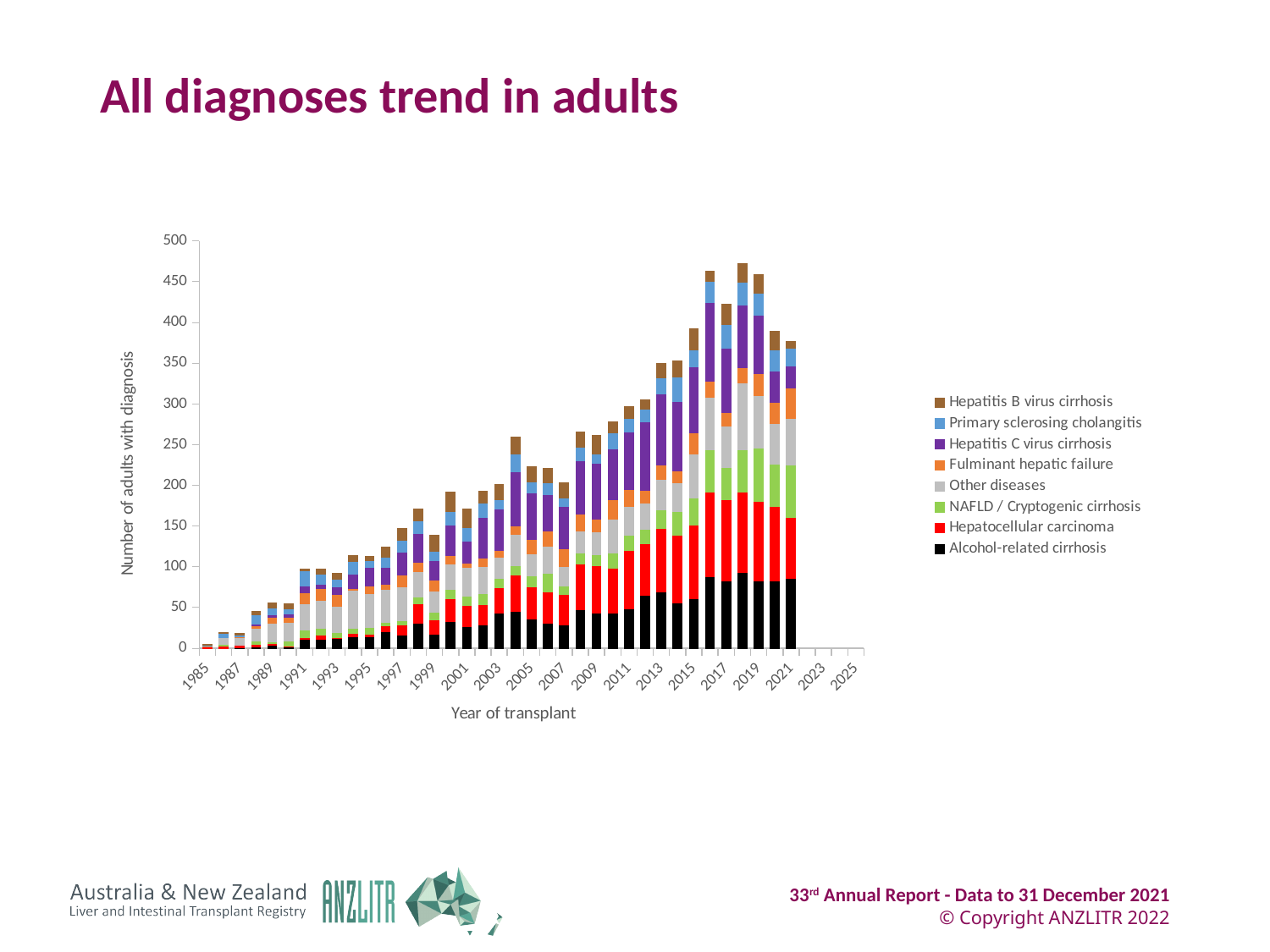
What kind of chart is shown on the slide? Stacked bar chart Is the total value for 1985 greater or less than 50? less Which year has the larger total, 1990 or 2000? 2000 Is the total value for 2021 greater or less than 400? less Is the total value for 2000 greater or less than 250? less Do the total values generally rise or fall from 1985 to 2021? rise Which year has the larger total, 2016 or 2021? 2016 What is the title of the vertical axis? Number of adults with diagnosis Which year has the lowest total number of adults with diagnosis? 1985 How many series does the legend list? 8